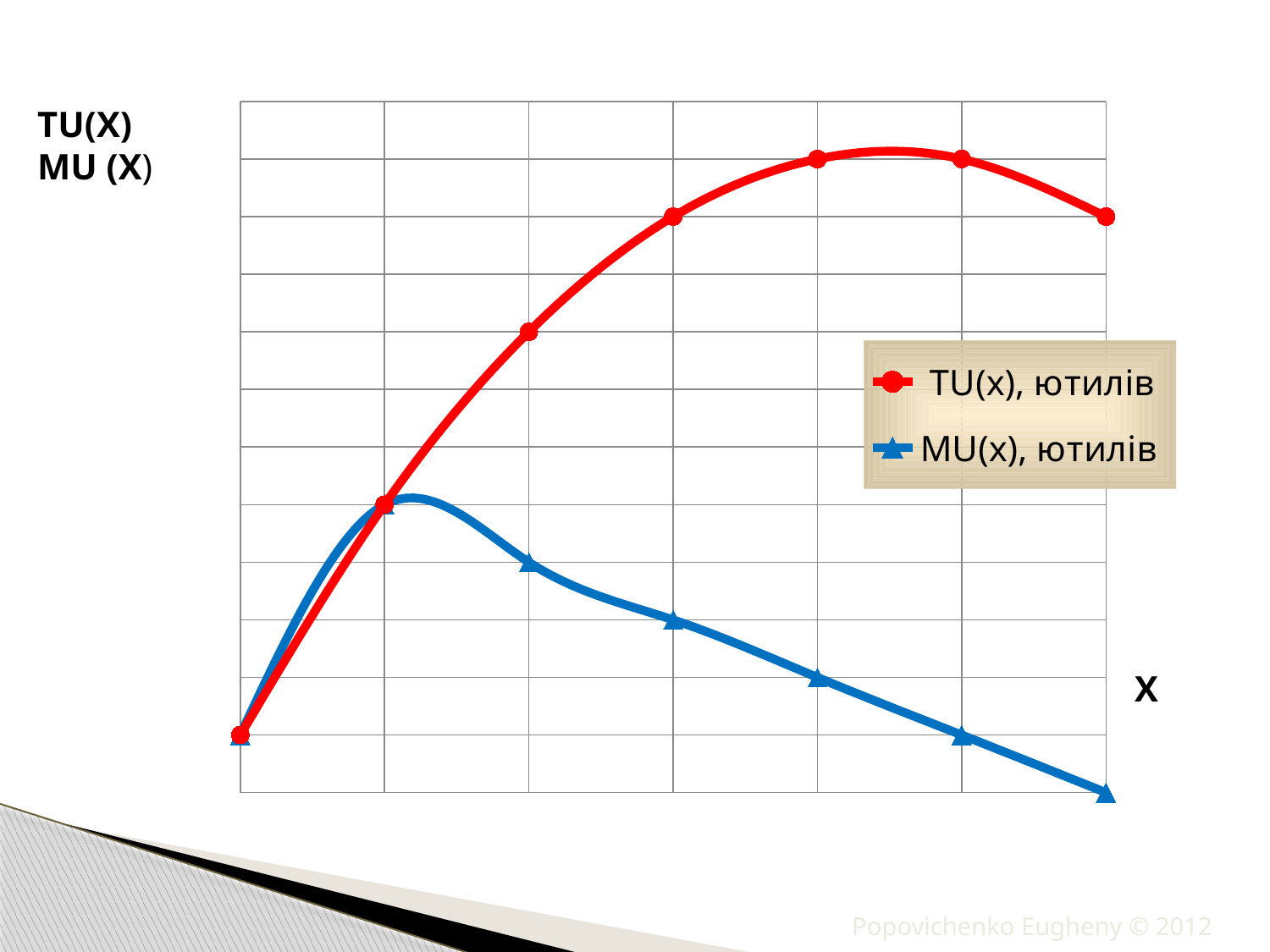
Does the TU(x), ютилів line rise or fall between its sixth point and its last point? fall How many series does the legend list? 2 How many data points are plotted for the MU(x), ютилів series? 7 What colour is the TU(x), ютилів line? red After reaching its peak at the second point, does the MU(x), ютилів line rise or fall along the x axis? fall What are the two series named in the legend? TU(x), ютилів and MU(x), ютилів At the fourth point from the left, which series is higher, TU(x), ютилів or MU(x), ютилів? TU(x), ютилів How many data points are plotted for the TU(x), ютилів series? 7 Does the TU(x), ютилів line rise or fall between its first point and its fifth point? rise At the rightmost point, which series has the higher value, TU(x), ютилів or MU(x), ютилів? TU(x), ютилів What kind of chart is shown on the slide? line chart